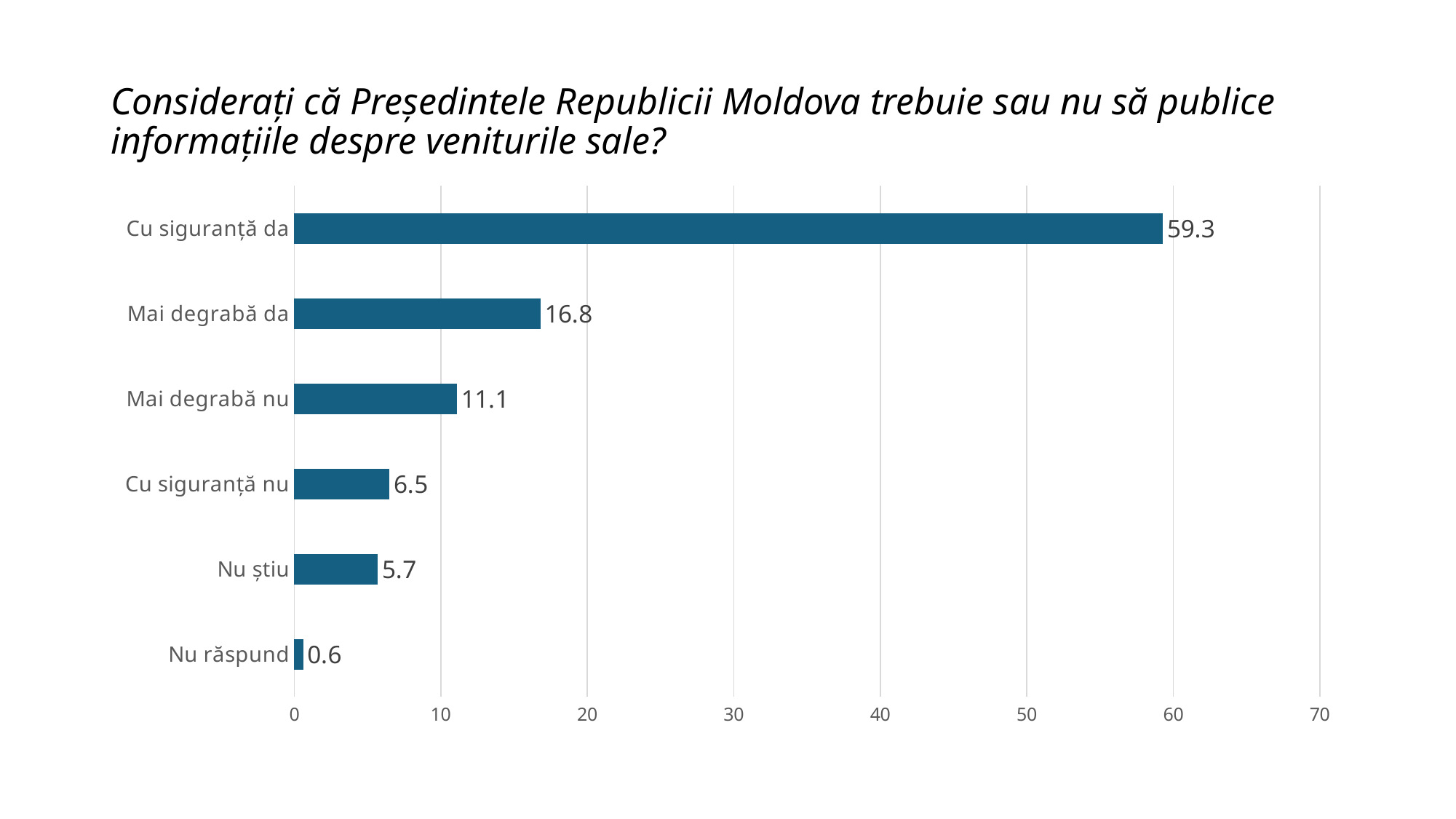
What is the value for "Mai degrabă nu"? 11.1 Is the value for "Cu siguranță da" greater or less than 50? greater What is the value for "Nu răspund"? 0.6 What is the difference between the values for "Cu siguranță da" and "Mai degrabă da"? 42.5 Which category has the lowest value? Nu răspund Which category has the highest value? Cu siguranță da Which is larger, the value for "Cu siguranță nu" or the value for "Nu știu"? Cu siguranță nu What is the difference between the values for "Mai degrabă da" and "Mai degrabă nu"? 5.7 What is the value for "Cu siguranță da"? 59.3 How many categories are shown in the chart? 6 What kind of chart is shown on the slide? bar chart What is the highest tick value shown on the horizontal axis? 70